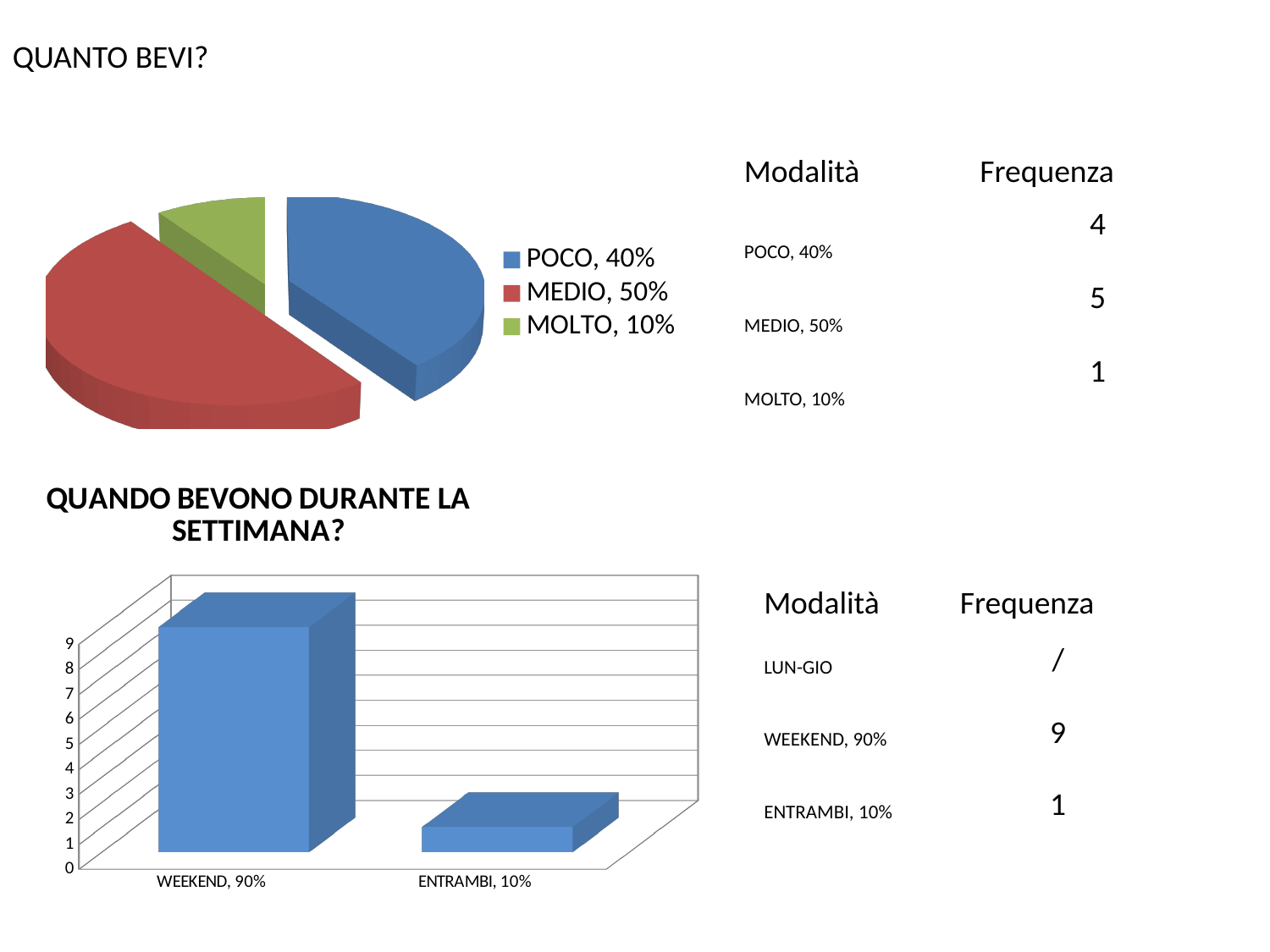
In the top pie chart, how many slices are there? 3 In the top pie chart, what share does MEDIO have? 50% In the top pie chart, which category has the smallest slice? MOLTO In the top pie chart, what share does MOLTO have? 10% In the bottom bar chart, which category has the taller bar? WEEKEND, 90% What type of chart is the bottom chart titled 'QUANDO BEVONO DURANTE LA SETTIMANA?'? bar chart In the bottom bar chart, how many bars are there? 2 In the top pie chart, what is the difference in share between MEDIO and MOLTO? 40% What type of chart is the top chart on the slide? pie chart In the top pie chart, what share does POCO have? 40% In the top pie chart, which category has the largest slice? MEDIO In the bottom bar chart, is the value for ENTRAMBI greater or less than 3? less